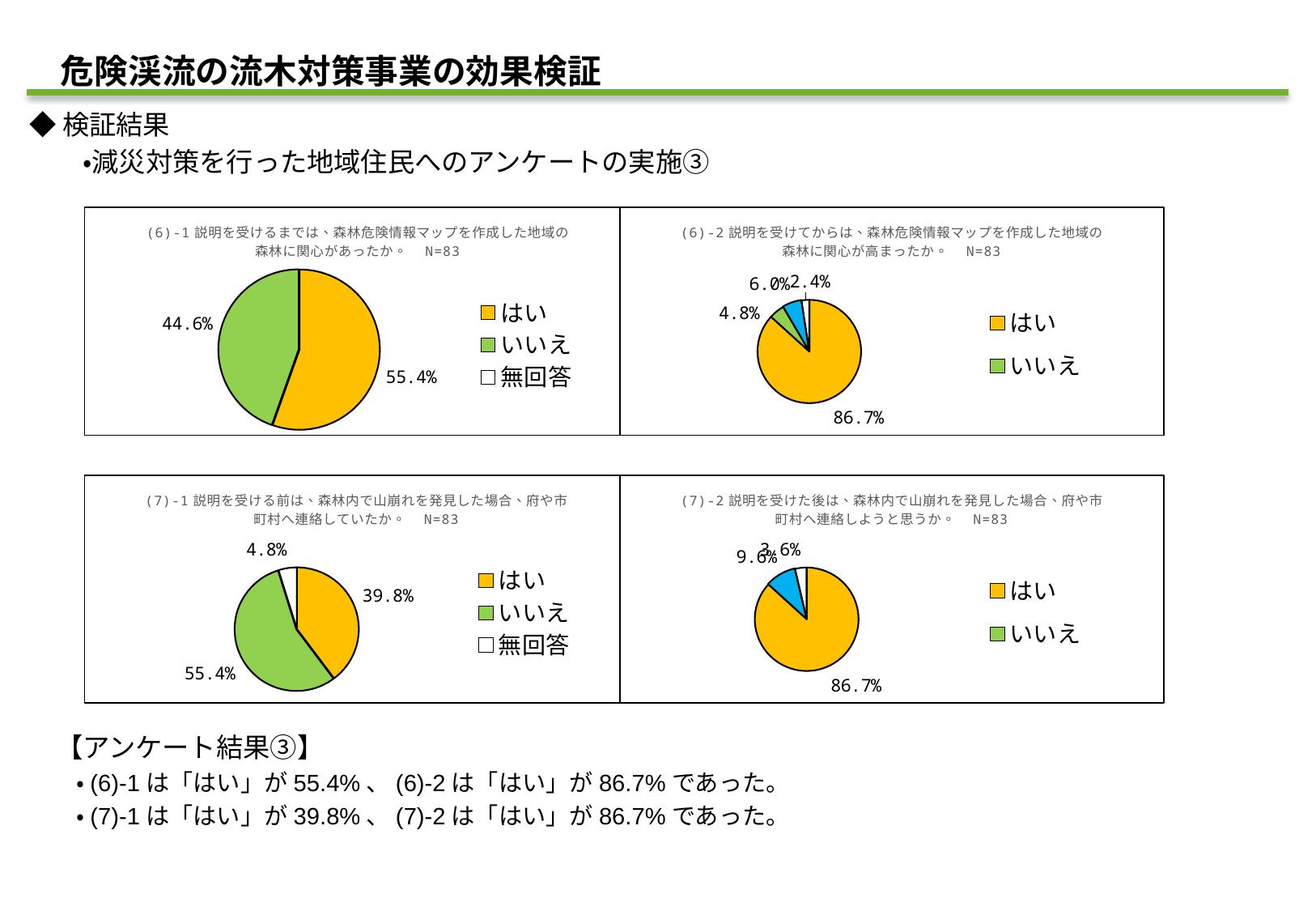
Which is larger: the はい share in the (7)-1 chart or the はい share in the (7)-2 chart? (7)-2 In the (6)-2 chart (top right), what percentage answered いいえ? 4.8% In the (6)-1 chart (top left), what percentage answered はい? 55.4% In the (7)-1 chart (bottom left), which response has the smallest share? 無回答 In the (6)-1 chart (top left), what is the difference between the はい and いいえ shares? 10.8% In the (6)-2 chart (top right), what percentage answered はい? 86.7% In the (7)-1 chart (bottom left), which response has the largest share? いいえ How many entries does the legend of the (6)-1 chart (top left) list? 3 What type of chart is the (7)-2 chart (bottom right)? Pie chart In the (7)-1 chart (bottom left), what percentage answered はい? 39.8% In the (6)-1 chart (top left), what percentage answered いいえ? 44.6% In the (7)-1 chart (bottom left), what percentage answered 無回答? 4.8%